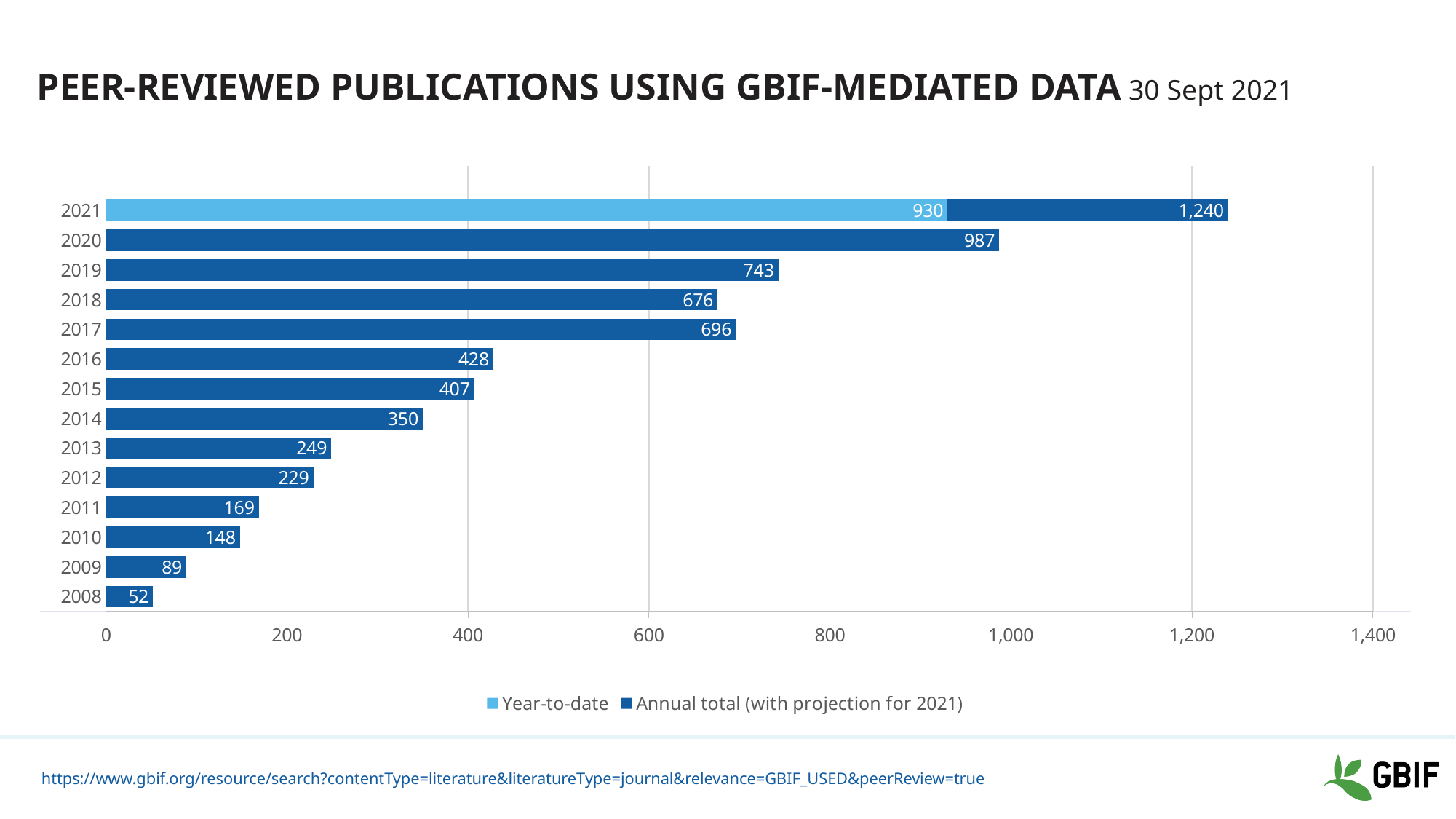
What is the difference between the annual totals for 2020 and 2019? 244 How many series does the legend list? 2 What is the year-to-date value for 2021? 930 Which year has the larger annual total, 2017 or 2018? 2017 What is the difference between the annual totals for 2016 and 2015? 21 Do the annual totals generally rise or fall from 2008 to 2020? rise Which year has the lowest annual total? 2008 What is the projected annual total for 2021? 1,240 What is the annual total for 2008? 52 How many years are shown on the chart? 14 What is the annual total of peer-reviewed publications for 2020? 987 What type of chart is shown on the slide? bar chart